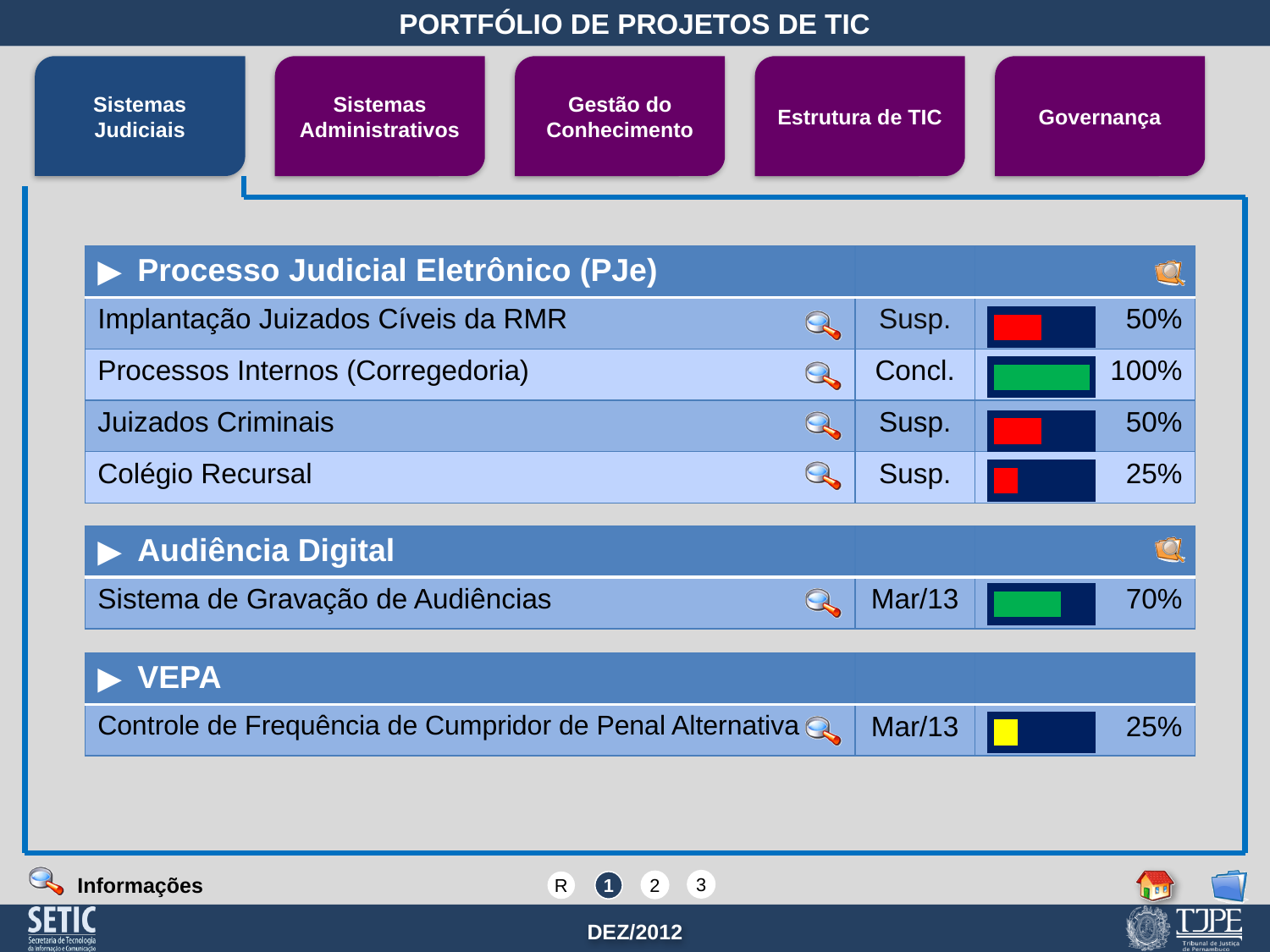
What is the difference in completion percentage between Processos Internos (Corregedoria) and Colégio Recursal? 75% How many projects in total have progress bars on the slide? 6 How many projects are listed under the Processo Judicial Eletrônico (PJe) group? 4 Which has a higher completion percentage, Sistema de Gravação de Audiências or Juizados Criminais? Sistema de Gravação de Audiências Which project under Processo Judicial Eletrônico (PJe) has the highest completion percentage? Processos Internos (Corregedoria) What status is shown for Processos Internos (Corregedoria)? Concl. What colour is the progress bar fill for Controle de Frequência de Cumpridor de Penal Alternativa? Yellow What is the completion percentage shown for Sistema de Gravação de Audiências? 70% What is the completion percentage shown for Controle de Frequência de Cumpridor de Penal Alternativa? 25% What is the completion percentage shown for Implantação Juizados Cíveis da RMR? 50% What is the completion percentage shown for Processos Internos (Corregedoria)? 100% Which project under Processo Judicial Eletrônico (PJe) has the lowest completion percentage? Colégio Recursal